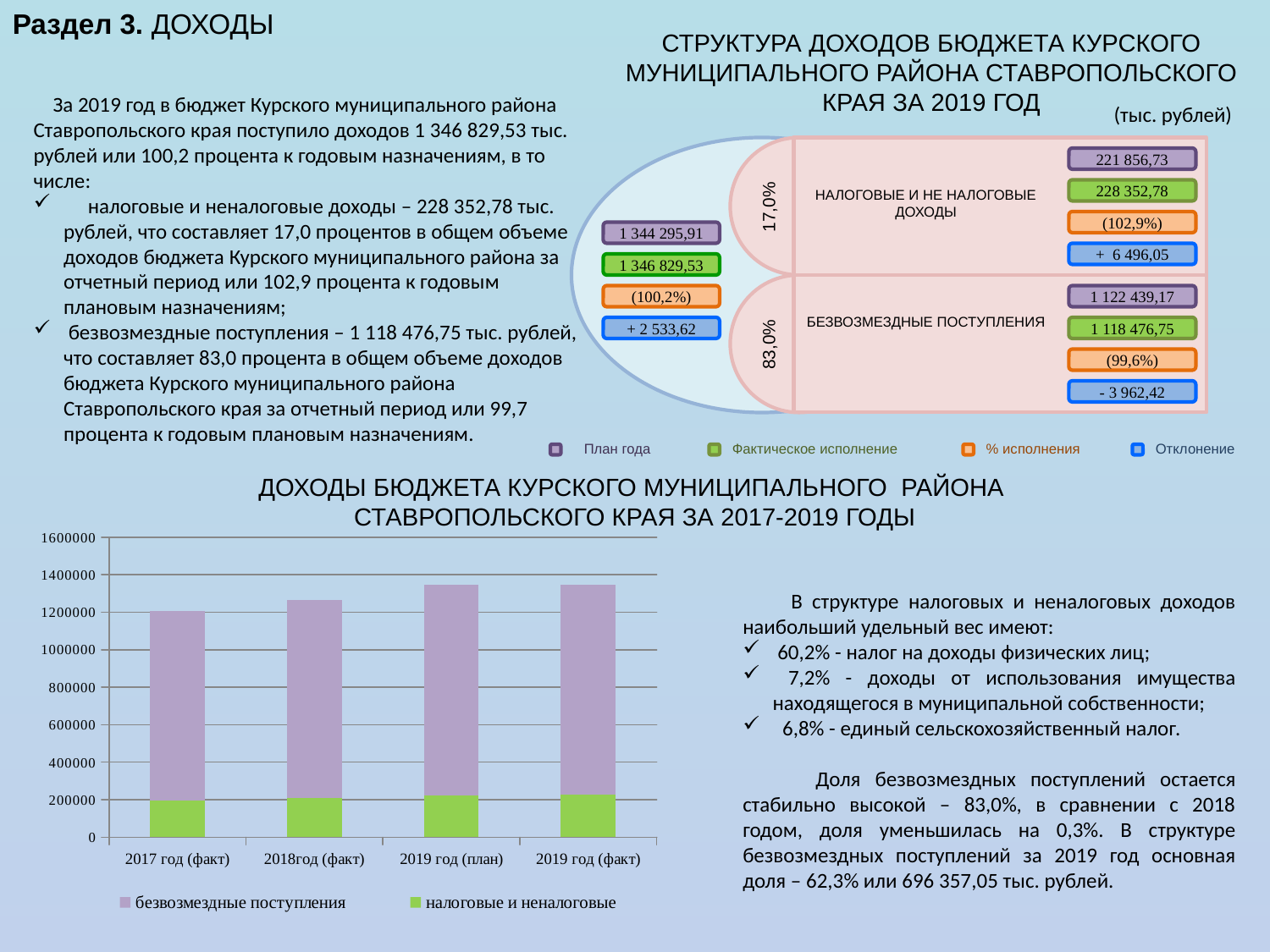
In the bar chart at the bottom of the slide, how many series does the legend list? 2 In the bar chart at the bottom of the slide, is the value of "налоговые и неналоговые" for 2019 год (факт) greater or less than 400000? less In the bar chart at the bottom of the slide, is the total bar for 2018год (факт) greater or less than 1200000? greater In the bar chart at the bottom of the slide, do the total bar heights rise or fall from 2017 год (факт) to 2019 год (план)? rise In the bar chart at the bottom of the slide, how many categories are shown on the x axis? 4 In the bar chart at the bottom of the slide, which series has the larger segment in the 2019 год (факт) bar: "безвозмездные поступления" or "налоговые и неналоговые"? безвозмездные поступления What kind of chart is shown at the bottom of the slide under the title "ДОХОДЫ БЮДЖЕТА КУРСКОГО МУНИЦИПАЛЬНОГО РАЙОНА СТАВРОПОЛЬСКОГО КРАЯ ЗА 2017-2019 ГОДЫ"? Stacked bar chart In the bar chart at the bottom of the slide, is the value of "безвозмездные поступления" for 2017 год (факт) greater or less than 800000? greater In the bar chart at the bottom of the slide, which category has the lowest total bar? 2017 год (факт) In the bar chart at the bottom of the slide, which total bar is taller: 2017 год (факт) or 2018год (факт)? 2018год (факт) In the bar chart at the bottom of the slide, which series is shown in green according to the legend? налоговые и неналоговые